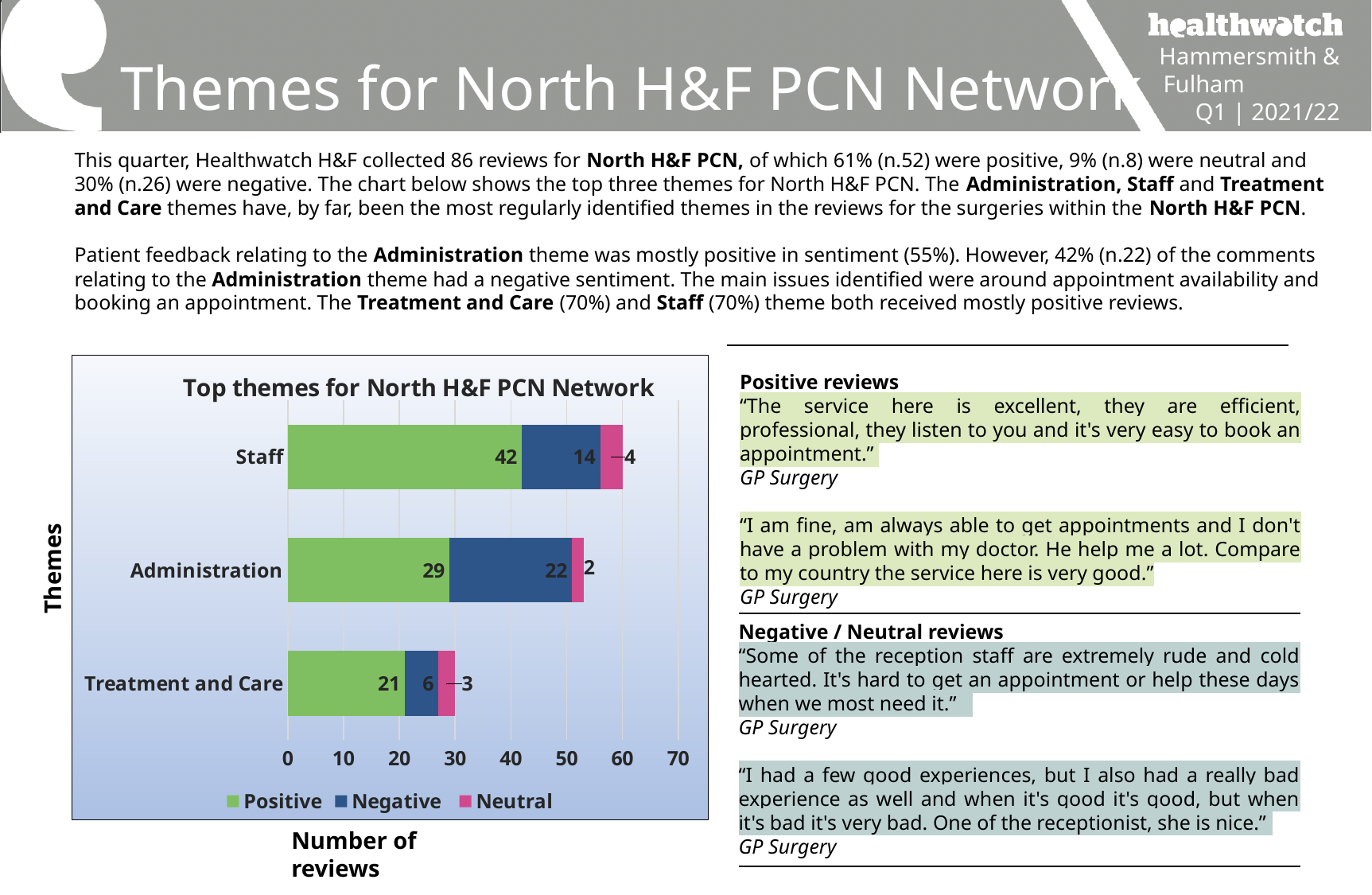
What is the number of Negative reviews for the Administration theme? 22 What is the title of the chart? Top themes for North H&F PCN Network Which theme has the highest number of Positive reviews? Staff How many themes are plotted on the chart? 3 How many series does the chart legend list? 3 What is the difference between the Positive and Negative reviews for the Administration theme? 7 What is the total number of reviews in the Staff bar? 60 What type of chart is shown on the slide? Stacked bar chart What is the number of Neutral reviews for the Treatment and Care theme? 3 Which theme has the lowest number of Negative reviews? Treatment and Care Which is larger: the Negative reviews for Staff or the Negative reviews for Administration? Administration What is the number of Positive reviews for the Staff theme? 42